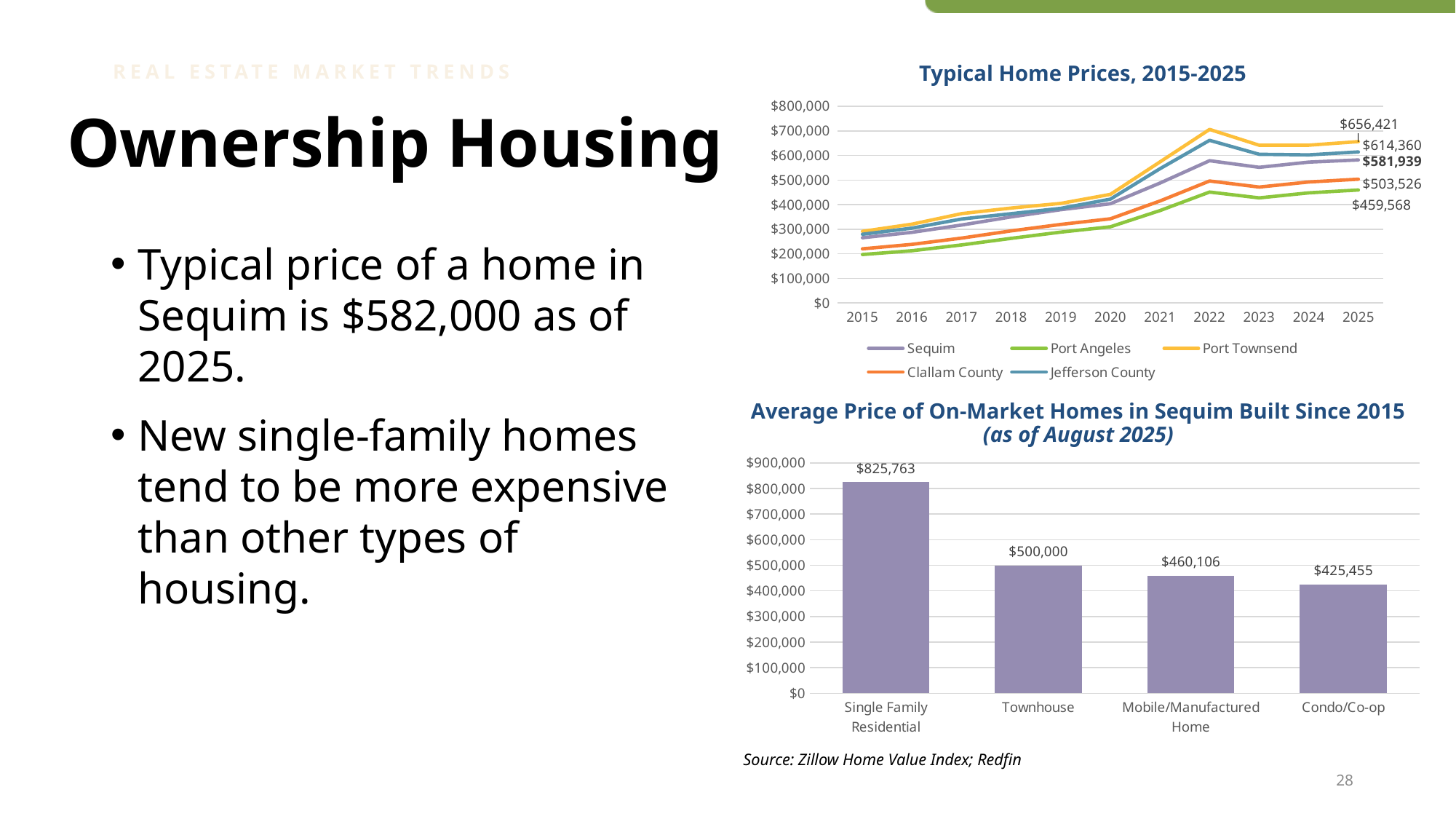
In the top chart (Typical Home Prices, 2015-2025), what is the typical home price for Sequim in 2025? $581,939 In the bottom chart (Average Price of On-Market Homes in Sequim Built Since 2015), how much higher is the Townhouse average price than the Condo/Co-op average price? $74,545 How many housing types are shown in the bottom chart (Average Price of On-Market Homes in Sequim Built Since 2015)? 4 How many series does the legend of the top chart (Typical Home Prices, 2015-2025) list? 5 What kind of chart is the bottom chart (Average Price of On-Market Homes in Sequim Built Since 2015)? Bar chart In the top chart (Typical Home Prices, 2015-2025), is the value for Jefferson County in 2022 greater or less than $600,000? greater In the bottom chart (Average Price of On-Market Homes in Sequim Built Since 2015), which is larger: the average price for Mobile/Manufactured Home or for Condo/Co-op? Mobile/Manufactured Home In the top chart (Typical Home Prices, 2015-2025), do typical home prices generally rise or fall from 2015 to 2025? Rise In the bottom chart (Average Price of On-Market Homes in Sequim Built Since 2015), what is the average price of a Single Family Residential home? $825,763 In the bottom chart (Average Price of On-Market Homes in Sequim Built Since 2015), which housing type has the lowest average price? Condo/Co-op In the bottom chart (Average Price of On-Market Homes in Sequim Built Since 2015), which housing type has the highest average price? Single Family Residential In the top chart (Typical Home Prices, 2015-2025), which area has the highest typical home price in 2025? Port Townsend